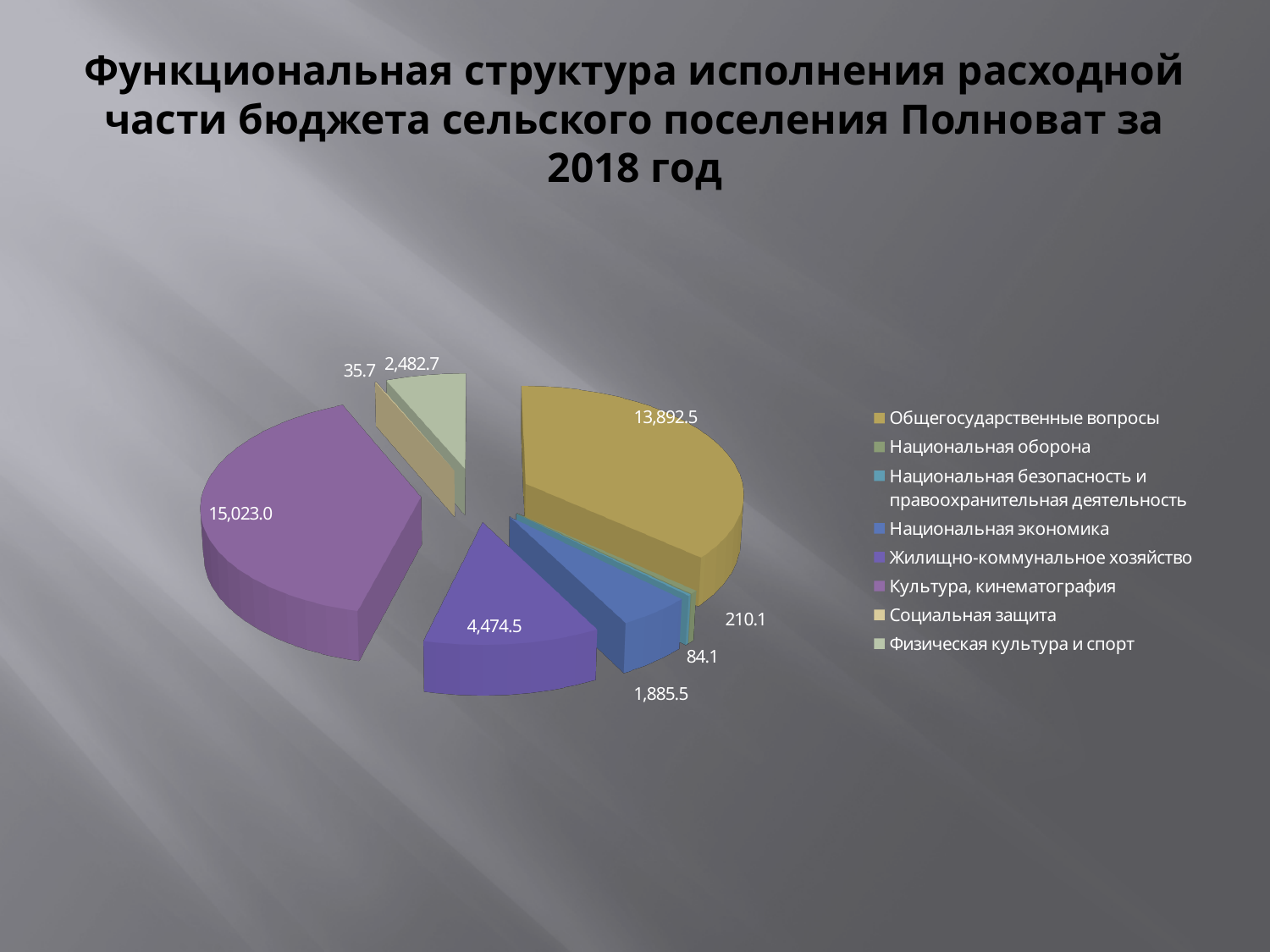
What is the value shown for Жилищно-коммунальное хозяйство? 4,474.5 How many categories does the legend of the pie chart list? 8 What year does the chart title say the budget execution data is for? 2018 What is the value shown for Общегосударственные вопросы? 13,892.5 What is the value shown for Физическая культура и спорт? 2,482.7 What is the value shown for Социальная защита? 35.7 What kind of chart is shown on the slide? pie chart Which is larger, Национальная экономика or Жилищно-коммунальное хозяйство? Жилищно-коммунальное хозяйство What is the value shown for Культура, кинематография? 15,023.0 Which category has the smallest slice of the pie? Социальная защита What is the difference between the values for Культура, кинематография and Общегосударственные вопросы? 1,130.5 Which category has the largest slice of the pie? Культура, кинематография